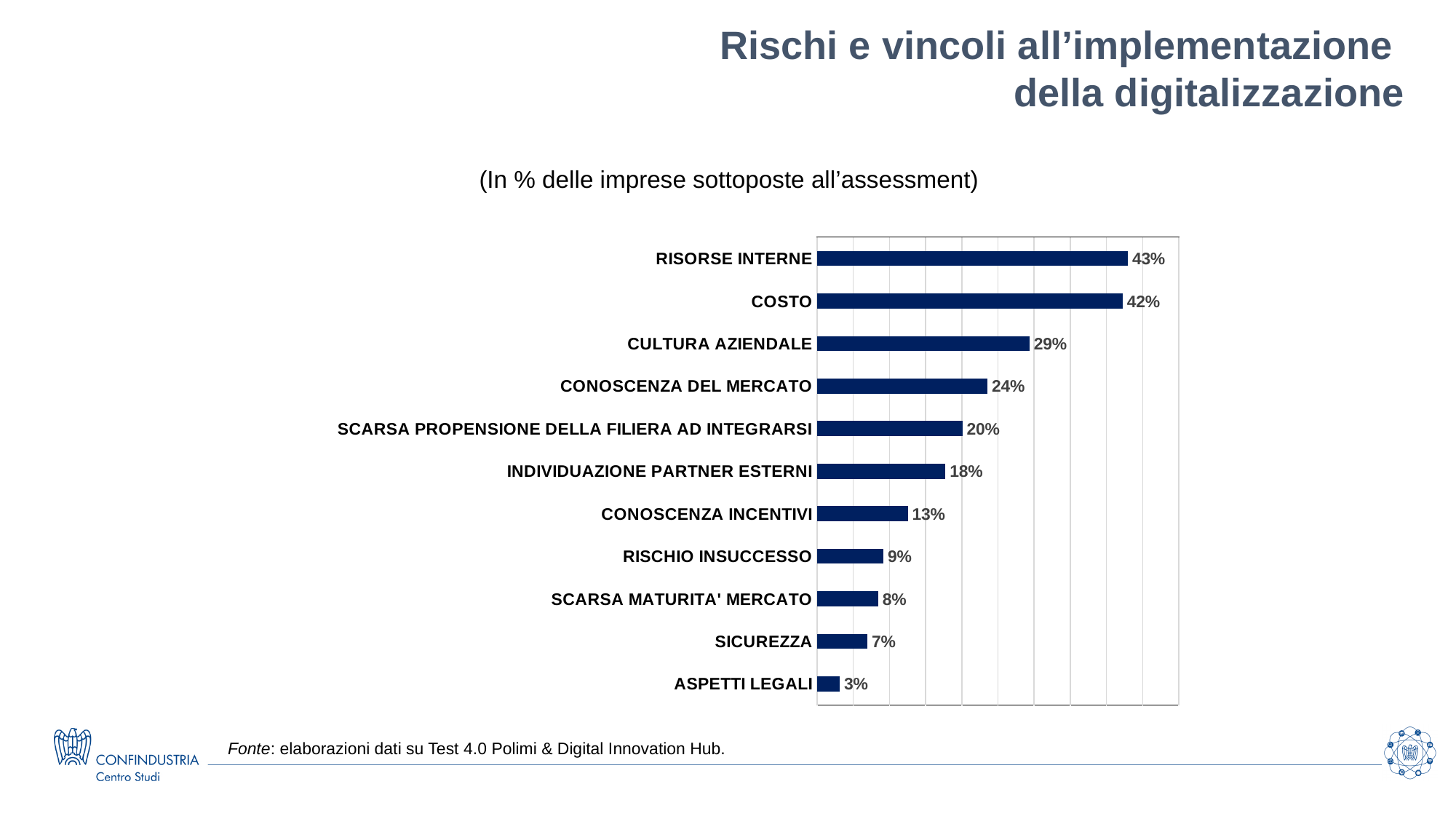
What is the difference between the values for SCARSA PROPENSIONE DELLA FILIERA AD INTEGRARSI and INDIVIDUAZIONE PARTNER ESTERNI? 2% What is the value for RISORSE INTERNE? 43% What is the subtitle shown above the chart? (In % delle imprese sottoposte all'assessment) What is the difference between the values for COSTO and CULTURA AZIENDALE? 13% What kind of chart is shown on the slide? Bar chart Which category has the highest value? RISORSE INTERNE What is the value for SICUREZZA? 7% Which category has the lowest value? ASPETTI LEGALI How many categories are shown in the chart? 11 Which is larger, the value for CONOSCENZA INCENTIVI or the value for RISCHIO INSUCCESSO? CONOSCENZA INCENTIVI What is the value for CONOSCENZA DEL MERCATO? 24% What is the value for SCARSA MATURITA' MERCATO? 8%